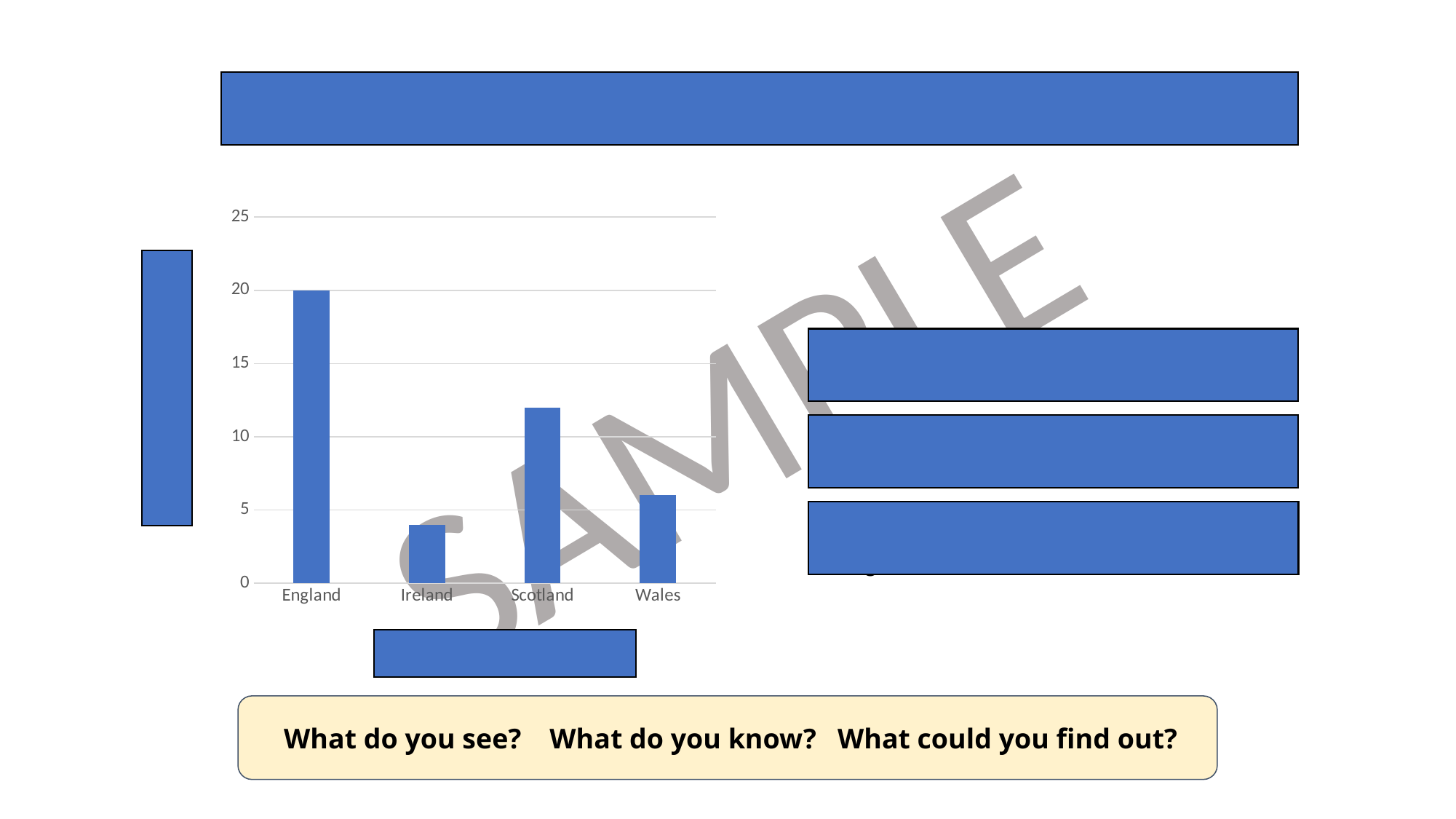
Is the value for Ireland greater or less than 5? less Is the value for Scotland greater or less than 15? less What is the value for England in the chart? 20 Which category has the highest bar in the chart? England Is the value for Wales greater or less than 5? greater How many categories are shown on the x axis of the chart? 4 What kind of chart is shown on the slide? bar chart What is the highest tick value shown on the vertical axis of the chart? 25 Which has the larger value, England or Ireland? England Which category has the lowest bar in the chart? Ireland Which has the larger value, Scotland or Wales? Scotland